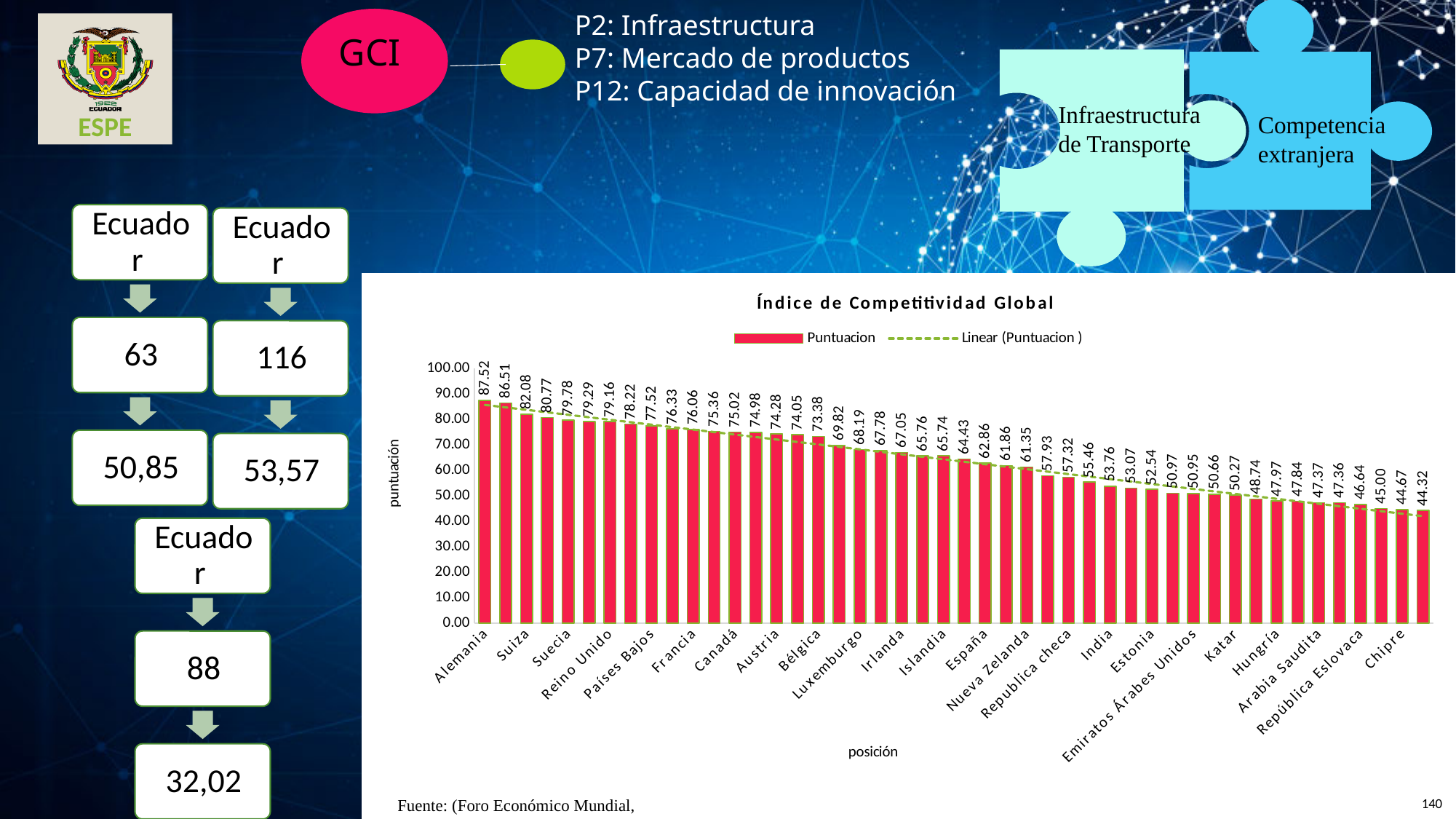
Is the value for Chipre greater or less than 50? less Do the values in the chart rise or fall from left to right along the x axis? fall Which category has the highest value in the chart? Alemania What label is shown on the vertical axis of the chart? puntuación What is the lowest value shown on a bar in the chart? 44.32 What kind of chart is shown under the title 'Índice de Competitividad Global'? bar chart How many entries does the chart's legend list? 2 What is the title of the chart on the slide? Índice de Competitividad Global What is the value for Alemania in the chart? 87.52 What is the difference between the highest bar value (87.52) and the lowest bar value (44.32) in the chart? 43.20 Is the value for Alemania greater or less than 80? greater Which has the larger value in the chart, Alemania or Chipre? Alemania